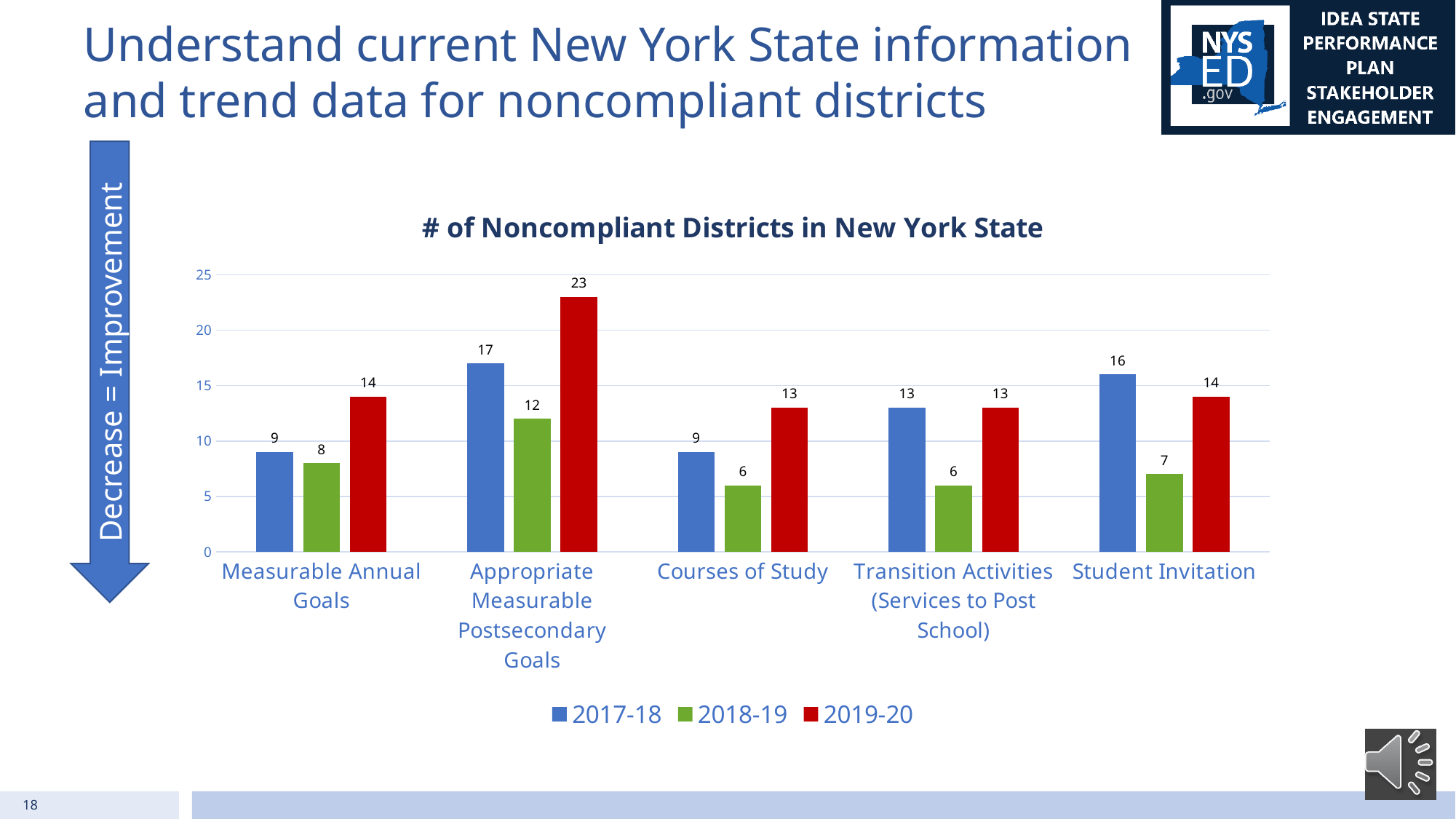
Which is larger for Transition Activities (Services to Post School): the 2017-18 value or the 2018-19 value? 2017-18 Which category has the highest value in 2019-20? Appropriate Measurable Postsecondary Goals What is the value for Courses of Study in 2018-19? 6 What is the value for Student Invitation in 2017-18? 16 What kind of chart is shown on the slide? Bar chart How many categories are shown on the x axis? 5 What is the value for Appropriate Measurable Postsecondary Goals in 2019-20? 23 Which colour represents the 2018-19 series? Green Which category has the lowest value in 2017-18? Measurable Annual Goals and Courses of Study (both 9) What is the title of the chart? # of Noncompliant Districts in New York State How many series does the legend list? 3 What is the difference between the 2019-20 and 2018-19 values for Appropriate Measurable Postsecondary Goals? 11